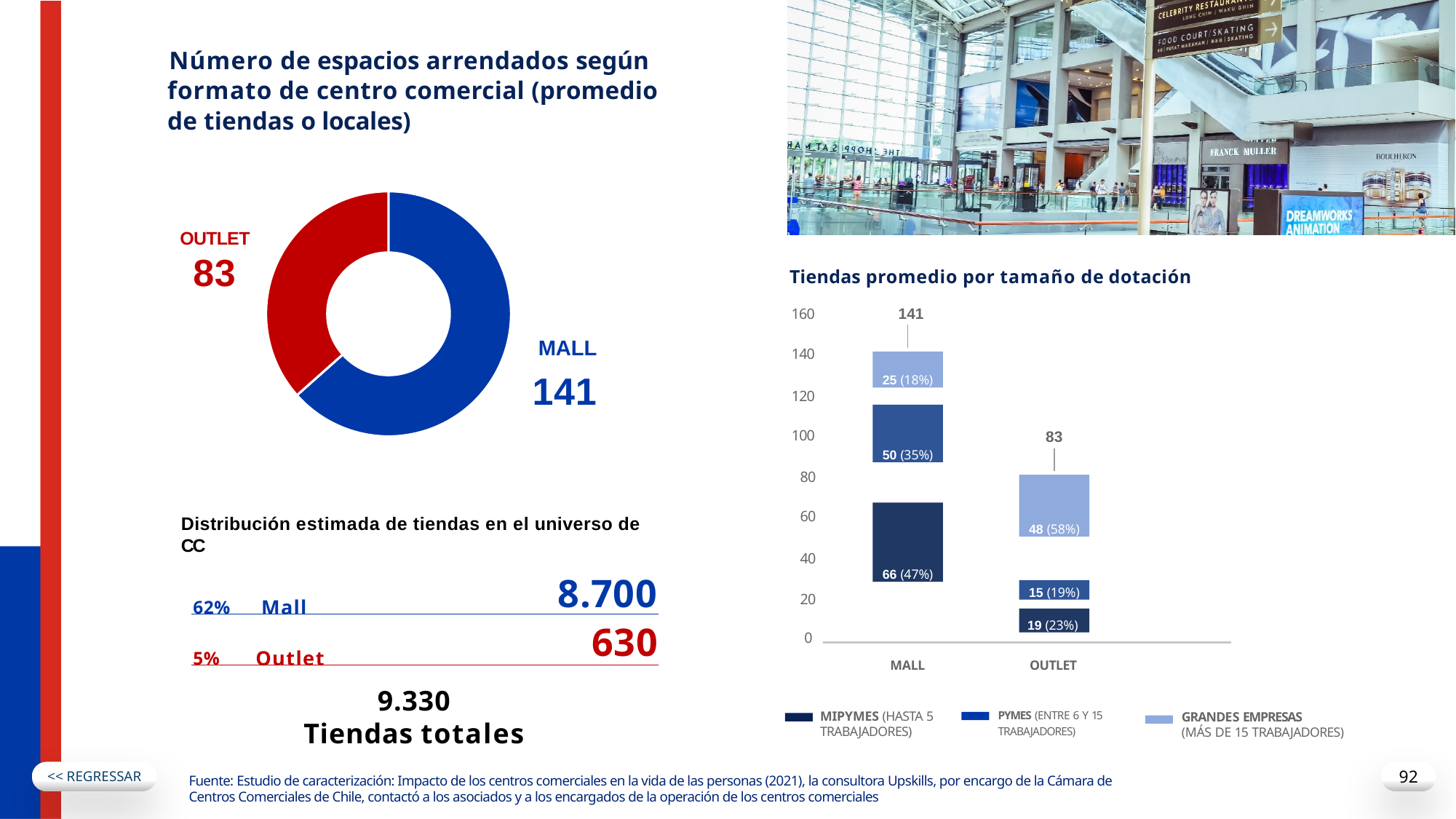
In the chart 'Tiendas promedio por tamaño de dotación', which segment is larger for OUTLET, MIPYMES or PYMES? MIPYMES In the chart 'Tiendas promedio por tamaño de dotación', what is the total of the stacked bar for OUTLET? 83 In the chart 'Tiendas promedio por tamaño de dotación', what is the GRANDES EMPRESAS value for OUTLET? 48 In the donut chart on the left, what is the value for OUTLET? 83 In the donut chart on the left, what is the difference between the MALL and OUTLET values? 58 In the chart 'Tiendas promedio por tamaño de dotación', what is the total of the stacked bar for MALL? 141 In the chart 'Tiendas promedio por tamaño de dotación', how many series does the legend list? 3 In the donut chart on the left, what is the value for MALL? 141 What kind of chart is the chart on the left of the slide? Donut (pie) chart In the chart 'Tiendas promedio por tamaño de dotación', what percentage share is shown for PYMES in the MALL bar? 35% In the donut chart on the left, which category has the larger value, MALL or OUTLET? MALL In the chart 'Tiendas promedio por tamaño de dotación', what is the MIPYMES value for MALL? 66